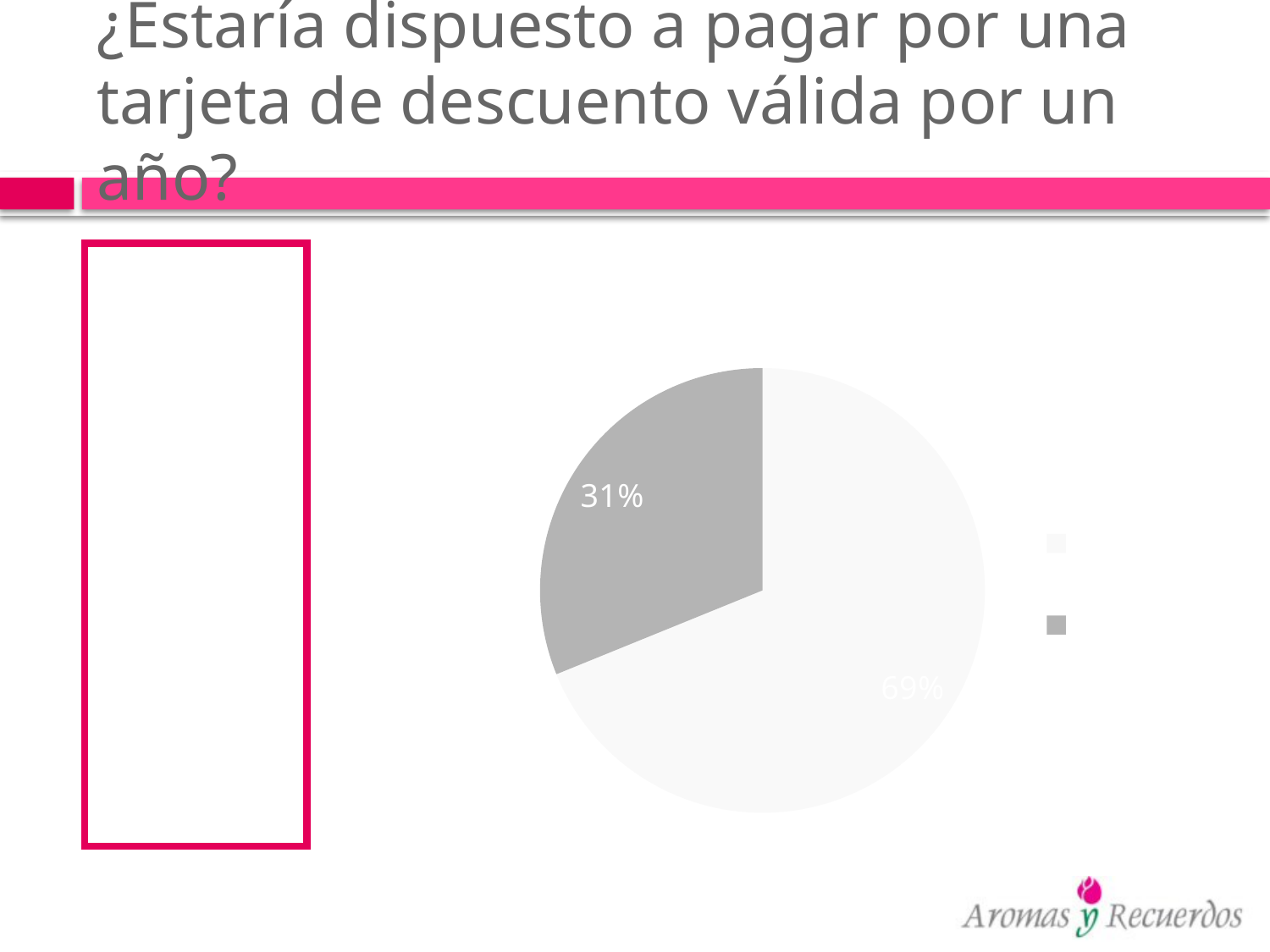
What is the total of the two slice percentages shown on the pie chart? 100% How many entries does the legend of the pie chart show? 2 How many slices does the pie chart have? 2 Is the value of the dark gray slice greater or less than 50%? less What colour is the slice labelled 31%? dark gray What kind of chart is shown on the slide? pie chart What is the difference in percentage points between the two slices of the pie chart? 38 What percentage is shown on the smaller slice of the pie chart? 31% Which slice is larger in the pie chart, the dark gray slice or the light gray slice? the light gray slice What percentage is shown on the larger slice of the pie chart? 69%